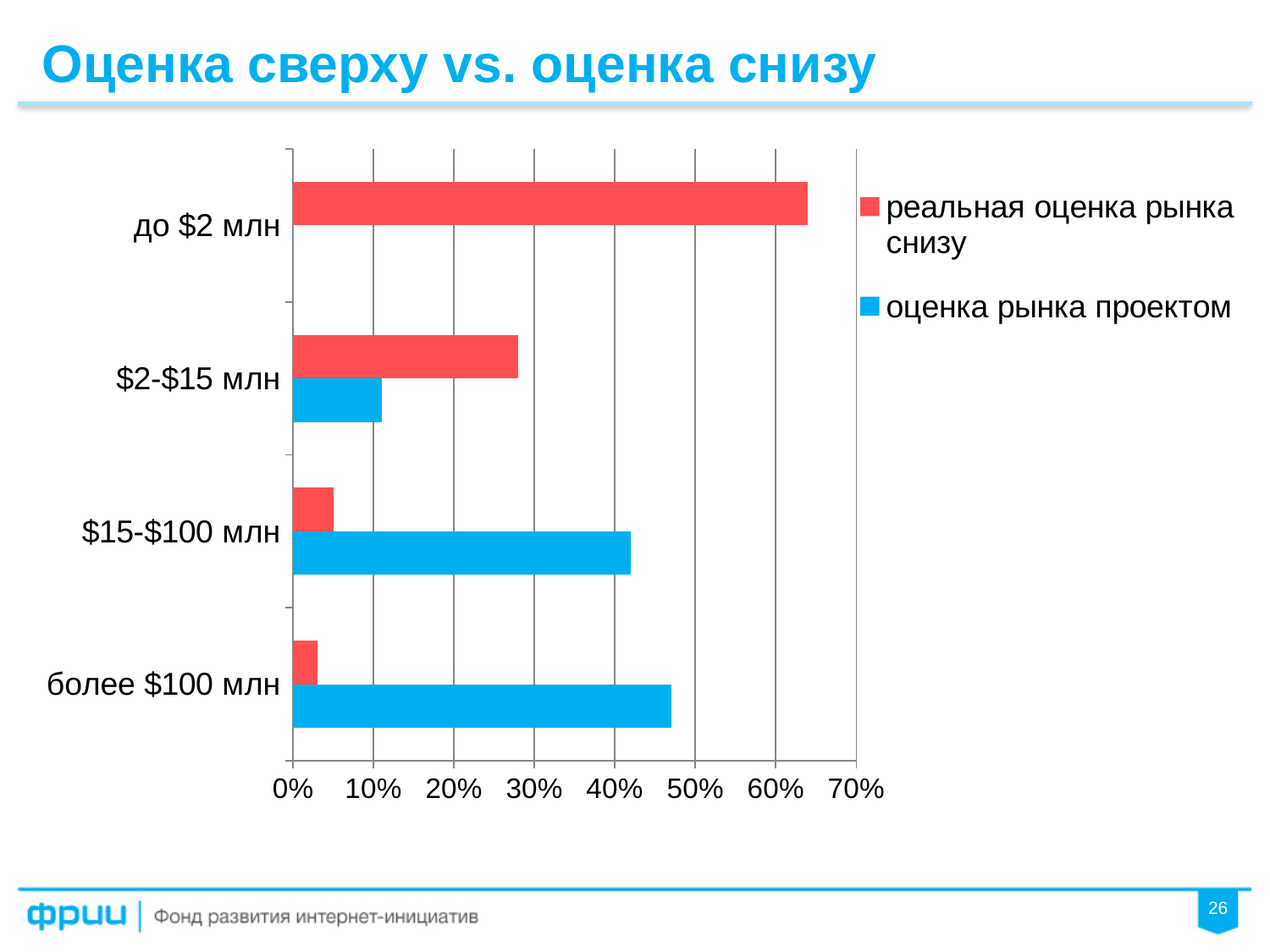
What colour represents the series 'оценка рынка проектом'? blue For the 'более $100 млн' category, which series has the larger value: 'реальная оценка рынка снизу' or 'оценка рынка проектом'? оценка рынка проектом Is the value for 'реальная оценка рынка снизу' in the 'до $2 млн' category greater or less than 60%? greater Which category has the highest value for 'реальная оценка рынка снизу'? до $2 млн For the '$2-$15 млн' category, which series has the larger value: 'реальная оценка рынка снизу' or 'оценка рынка проектом'? реальная оценка рынка снизу How many series does the legend list? 2 What kind of chart is shown on the slide? bar chart How many categories are shown on the vertical axis? 4 Is the value for 'реальная оценка рынка снизу' in the '$2-$15 млн' category greater or less than 30%? less Is the value for 'оценка рынка проектом' in the '$15-$100 млн' category greater or less than 40%? greater Which category has the lowest value for 'реальная оценка рынка снизу'? более $100 млн Which category has the highest value for 'оценка рынка проектом'? более $100 млн